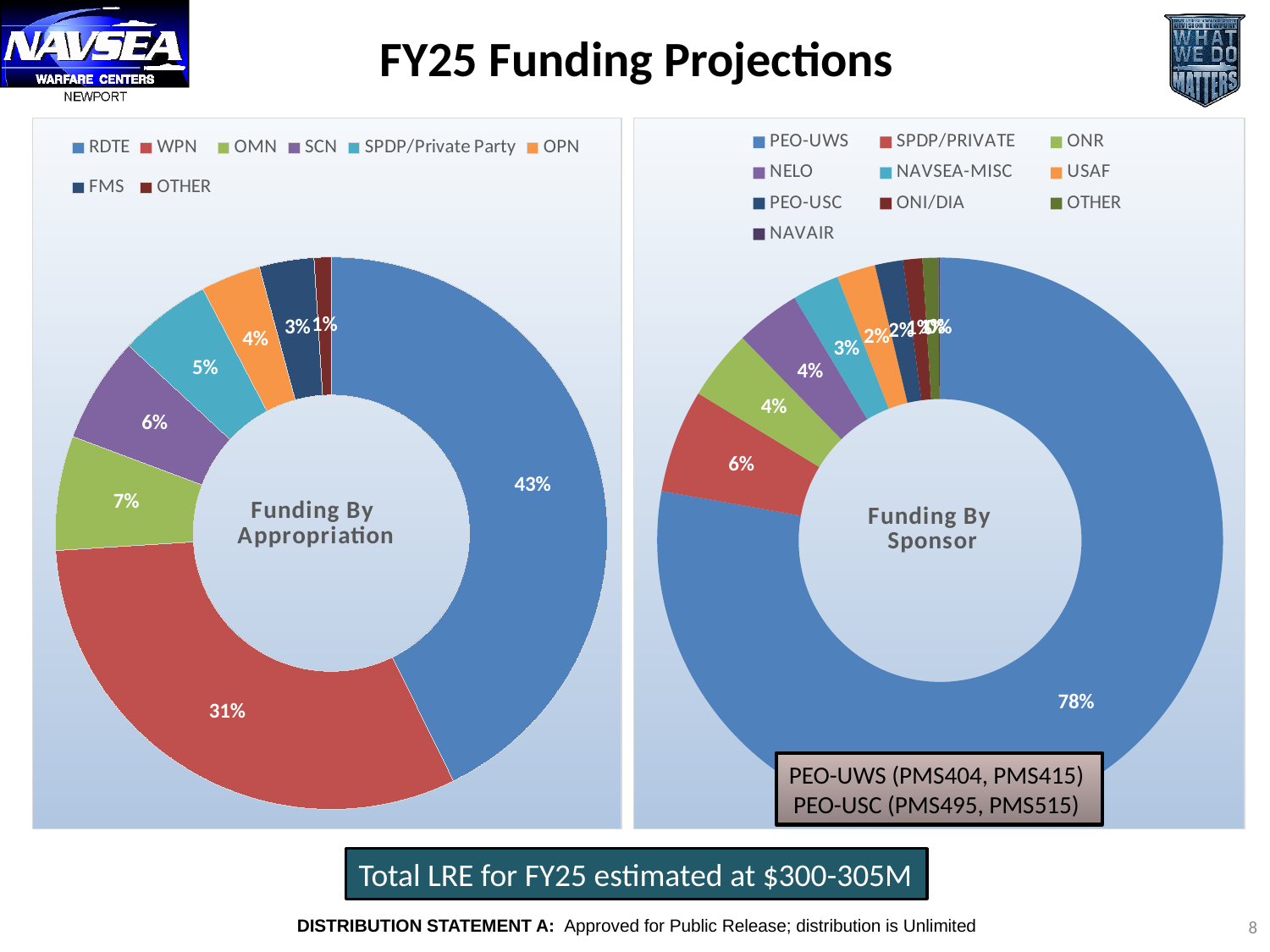
In the Funding By Appropriation chart, what is the difference between the RDTE and WPN shares? 12% In the Funding By Sponsor chart, which sponsor has the largest share? PEO-UWS In the Funding By Appropriation chart, what share does RDTE have? 43% In the Funding By Sponsor chart, what share does PEO-UWS have? 78% In the Funding By Appropriation chart, which category has the smallest share? OTHER What type of chart is the Funding By Sponsor chart? Pie (donut) chart In the Funding By Appropriation chart, what share does WPN have? 31% In the Funding By Appropriation chart, which category has the largest share? RDTE How many entries does the legend of the Funding By Sponsor chart list? 10 In the Funding By Sponsor chart, what share does SPDP/PRIVATE have? 6% How many entries does the legend of the Funding By Appropriation chart list? 8 In the Funding By Appropriation chart, what share does OMN have? 7%